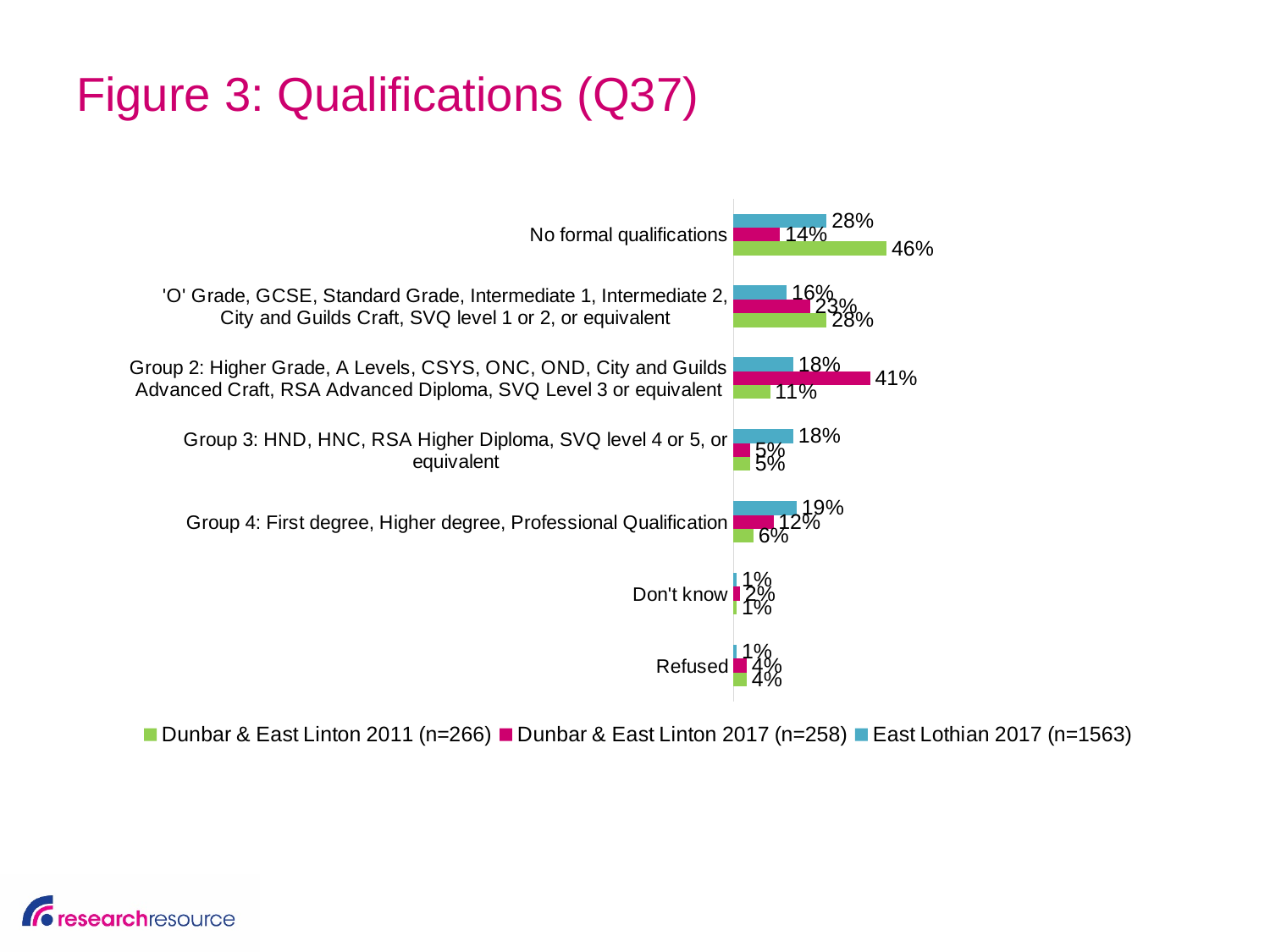
What is the difference between the Dunbar & East Linton 2011 and Dunbar & East Linton 2017 values for 'No formal qualifications'? 32 percentage points For 'Group 2: Higher Grade, A Levels, CSYS, ONC, OND, City and Guilds Advanced Craft, RSA Advanced Diploma, SVQ Level 3 or equivalent', which is larger: Dunbar & East Linton 2017 or East Lothian 2017? Dunbar & East Linton 2017 What is the value for 'Group 2: Higher Grade, A Levels, CSYS, ONC, OND, City and Guilds Advanced Craft, RSA Advanced Diploma, SVQ Level 3 or equivalent' for Dunbar & East Linton 2017 (n=258)? 41% What is the value for 'No formal qualifications' for East Lothian 2017 (n=1563)? 28% How many series does the legend list? 3 How many categories are shown on the chart? 7 Which category has the highest value for Dunbar & East Linton 2011 (n=266)? No formal qualifications What is the value for 'No formal qualifications' for Dunbar & East Linton 2017 (n=258)? 14% What is the value for 'No formal qualifications' for Dunbar & East Linton 2011 (n=266)? 46% What kind of chart is shown on the slide? Bar chart Which category has the highest value for Dunbar & East Linton 2017 (n=258)? Group 2: Higher Grade, A Levels, CSYS, ONC, OND, City and Guilds Advanced Craft, RSA Advanced Diploma, SVQ Level 3 or equivalent What is the value for 'Group 4: First degree, Higher degree, Professional Qualification' for East Lothian 2017 (n=1563)? 19%